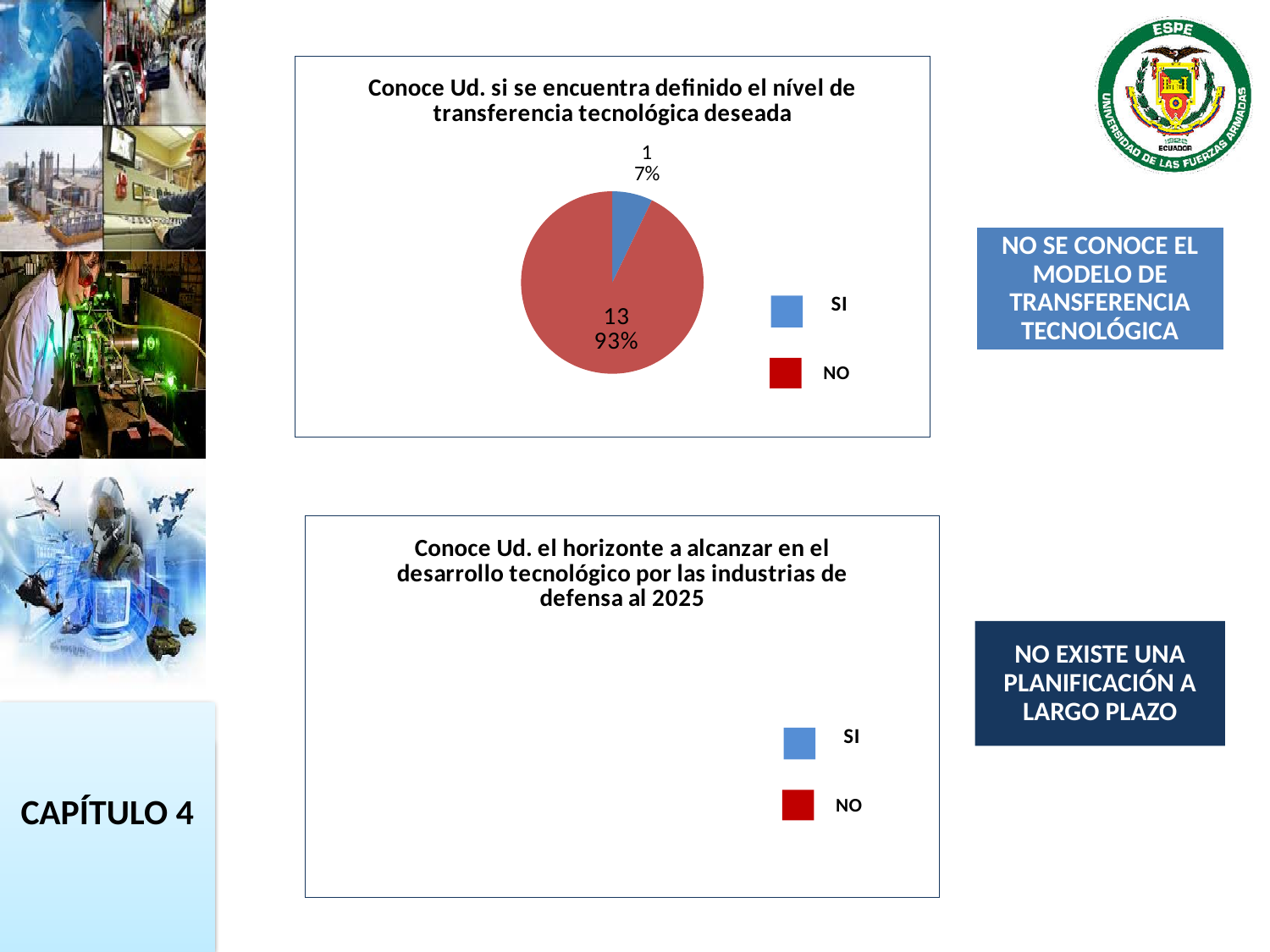
In the chart titled "Conoce Ud. si se encuentra definido el nível de transferencia tecnológica deseada", what is the difference between the counts for NO and SI? 12 In the chart titled "Conoce Ud. si se encuentra definido el nível de transferencia tecnológica deseada", what percentage of the pie is the NO slice? 93% In the chart titled "Conoce Ud. si se encuentra definido el nível de transferencia tecnológica deseada", which is larger, the SI slice or the NO slice? NO In the chart titled "Conoce Ud. si se encuentra definido el nível de transferencia tecnológica deseada", what is the count shown for SI? 1 In the chart titled "Conoce Ud. si se encuentra definido el nível de transferencia tecnológica deseada", how many categories does the legend list? 2 In the chart titled "Conoce Ud. si se encuentra definido el nível de transferencia tecnológica deseada", which category has the smallest slice? SI In the chart titled "Conoce Ud. si se encuentra definido el nível de transferencia tecnológica deseada", what percentage of the pie is the SI slice? 7% In the chart titled "Conoce Ud. si se encuentra definido el nível de transferencia tecnológica deseada", what kind of chart is shown? pie chart In the chart titled "Conoce Ud. si se encuentra definido el nível de transferencia tecnológica deseada", which category has the largest slice? NO In the chart titled "Conoce Ud. si se encuentra definido el nível de transferencia tecnológica deseada", what colour is the NO slice? red In the chart titled "Conoce Ud. si se encuentra definido el nível de transferencia tecnológica deseada", what is the count shown for NO? 13 In the lower chart titled "Conoce Ud. el horizonte a alcanzar en el desarrollo tecnológico por las industrias de defensa al 2025", what entries does the legend list? SI and NO